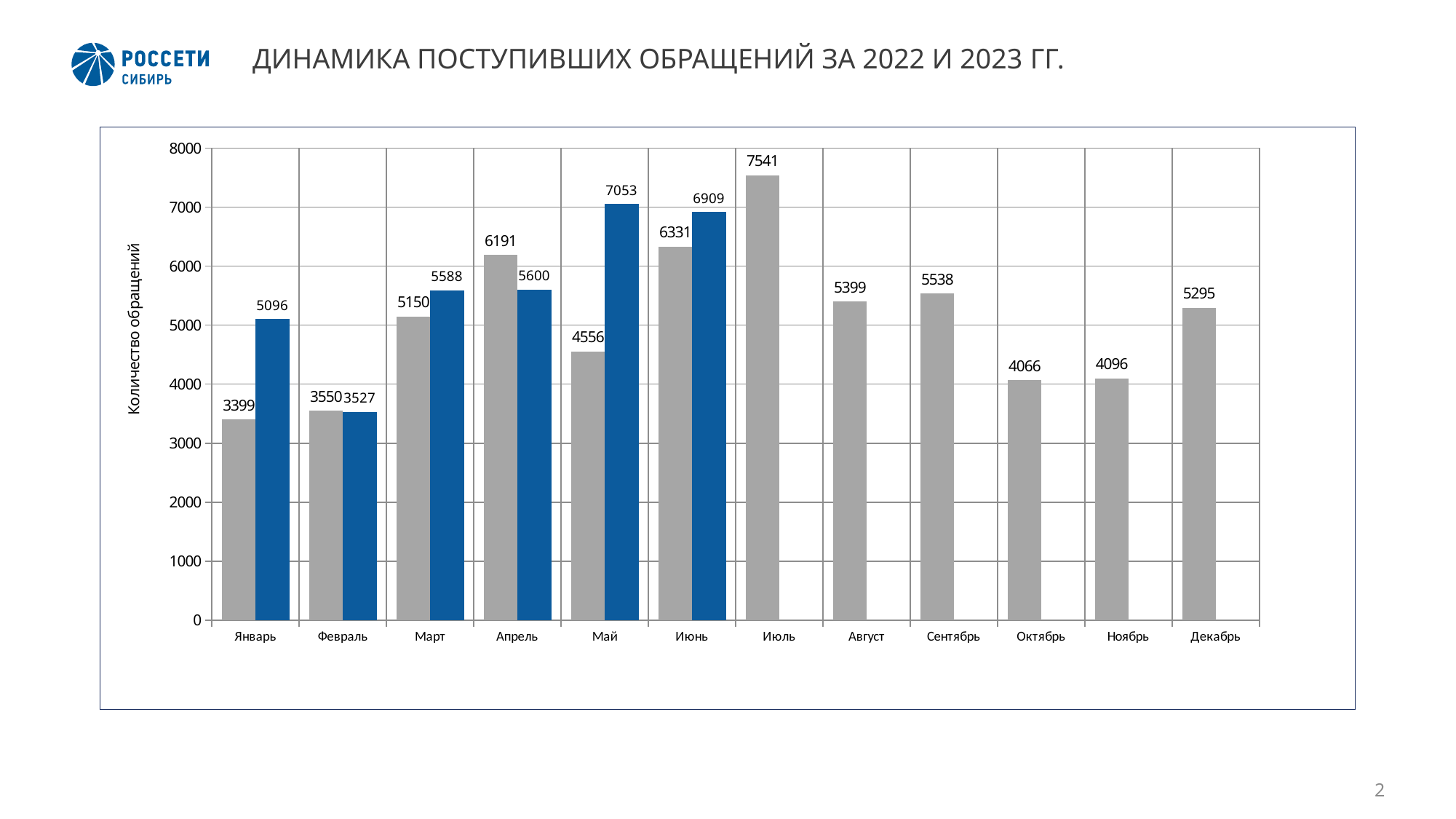
What type of chart is shown on the slide? bar chart How many months have a blue bar? 6 What is the value of the gray bar for Июль? 7541 Which month has the lowest gray bar? Январь What is the value of the gray bar for Январь? 3399 What is the label of the vertical axis? Количество обращений How many months are shown on the x axis? 12 Which month has the highest gray bar? Июль What is the value of the gray bar for Декабрь? 5295 Which is larger for Февраль, the gray bar or the blue bar? the gray bar What is the difference between the blue bar and the gray bar for Январь? 1697 What is the value of the blue bar for Май? 7053